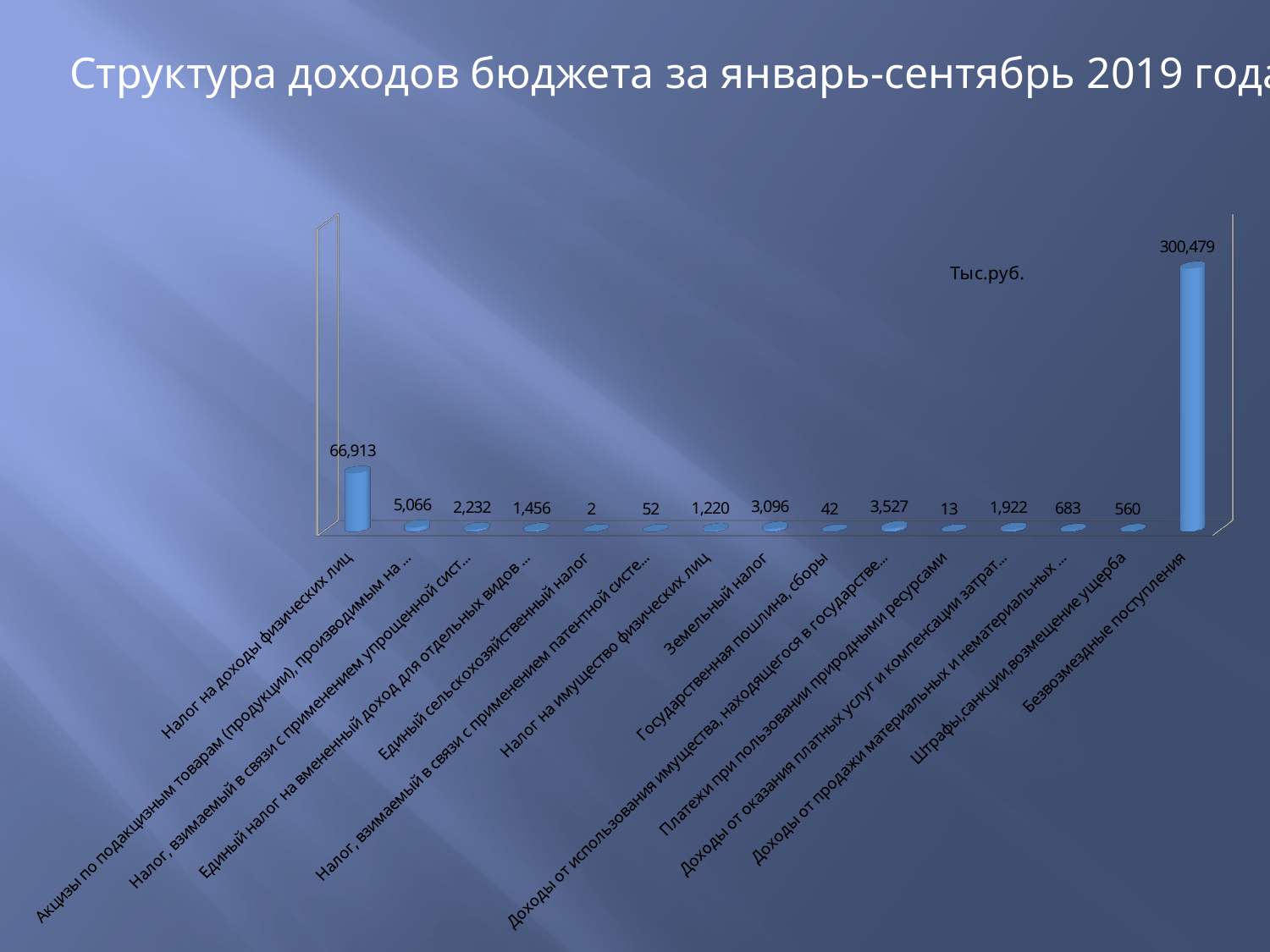
What unit is indicated on the chart? Тыс.руб. What kind of chart is shown on the slide? Bar chart Which is larger: the value for Земельный налог or the value for Налог на имущество физических лиц? Земельный налог What is the value for Единый сельскохозяйственный налог? 2 What is the value for Безвозмездные поступления? 300,479 How many categories are shown in the chart? 15 What is the difference between the values for Безвозмездные поступления and Налог на доходы физических лиц? 233,566 What is the value for Земельный налог? 3,096 Which category has the lowest value? Единый сельскохозяйственный налог What is the value for Налог на доходы физических лиц? 66,913 Which category has the highest value? Безвозмездные поступления What is the value for Штрафы,санкции,возмещение ущерба? 560